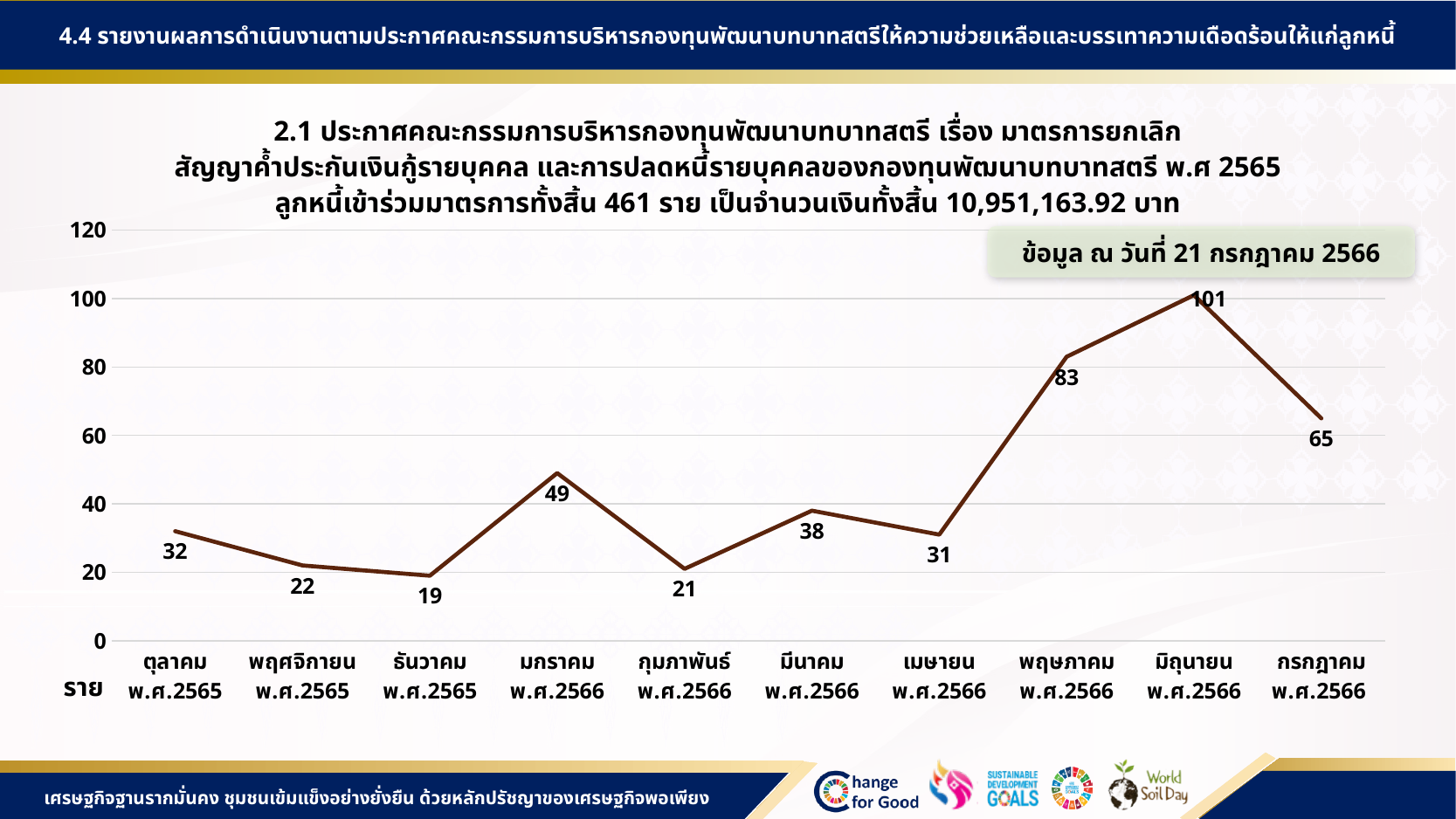
What is the value for พฤษภาคม พ.ศ.2566? 83 Does the value rise or fall from พฤศจิกายน พ.ศ.2565 to ธันวาคม พ.ศ.2565? Fall What is the value for มกราคม พ.ศ.2566? 49 Which is larger, the value for มีนาคม พ.ศ.2566 or the value for เมษายน พ.ศ.2566? มีนาคม พ.ศ.2566 Which month has the lowest value? ธันวาคม พ.ศ.2565 What type of chart is shown on the slide? Line chart Which month has the highest value? มิถุนายน พ.ศ.2566 What is the difference between the values for มิถุนายน พ.ศ.2566 and กรกฎาคม พ.ศ.2566? 36 What is the date shown in the data note box on the chart? 21 กรกฎาคม 2566 Is the value for พฤษภาคม พ.ศ.2566 greater or less than 60? greater How many months are plotted on the chart? 10 What is the value for ตุลาคม พ.ศ.2565? 32